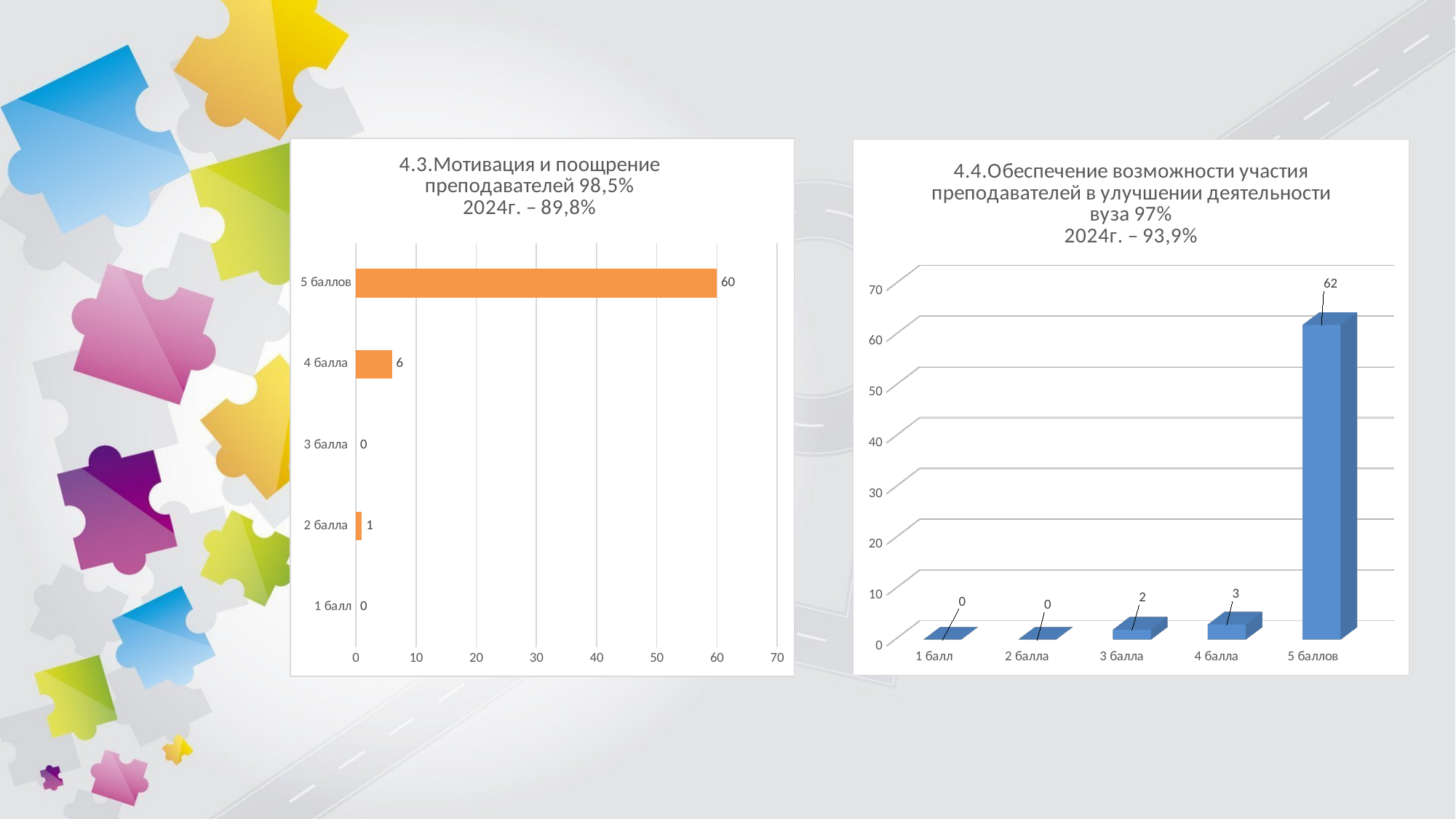
In the right chart (4.4. Обеспечение возможности участия преподавателей), what colour are the bars? Blue In the left chart (4.3. Мотивация и поощрение преподавателей), what is the value for 4 балла? 6 In the right chart (4.4. Обеспечение возможности участия преподавателей), what is the value for 3 балла? 2 In the left chart (4.3. Мотивация и поощрение преподавателей), what is the value for 2 балла? 1 In the right chart (4.4. Обеспечение возможности участия преподавателей), which is larger: the value for 4 балла or 3 балла? 4 балла In the left chart (4.3. Мотивация и поощрение преподавателей), what is the value for 5 баллов? 60 In the left chart (4.3. Мотивация и поощрение преподавателей), what is the difference between the values for 5 баллов and 4 балла? 54 In the right chart (4.4. Обеспечение возможности участия преподавателей), what is the difference between the values for 5 баллов and 4 балла? 59 In the left chart (4.3. Мотивация и поощрение преподавателей), which category has the highest value? 5 баллов In the left chart (4.3. Мотивация и поощрение преподавателей), how many categories are shown? 5 What type of chart is the left chart (4.3. Мотивация и поощрение преподавателей)? Bar chart In the right chart (4.4. Обеспечение возможности участия преподавателей), what is the value for 5 баллов? 62